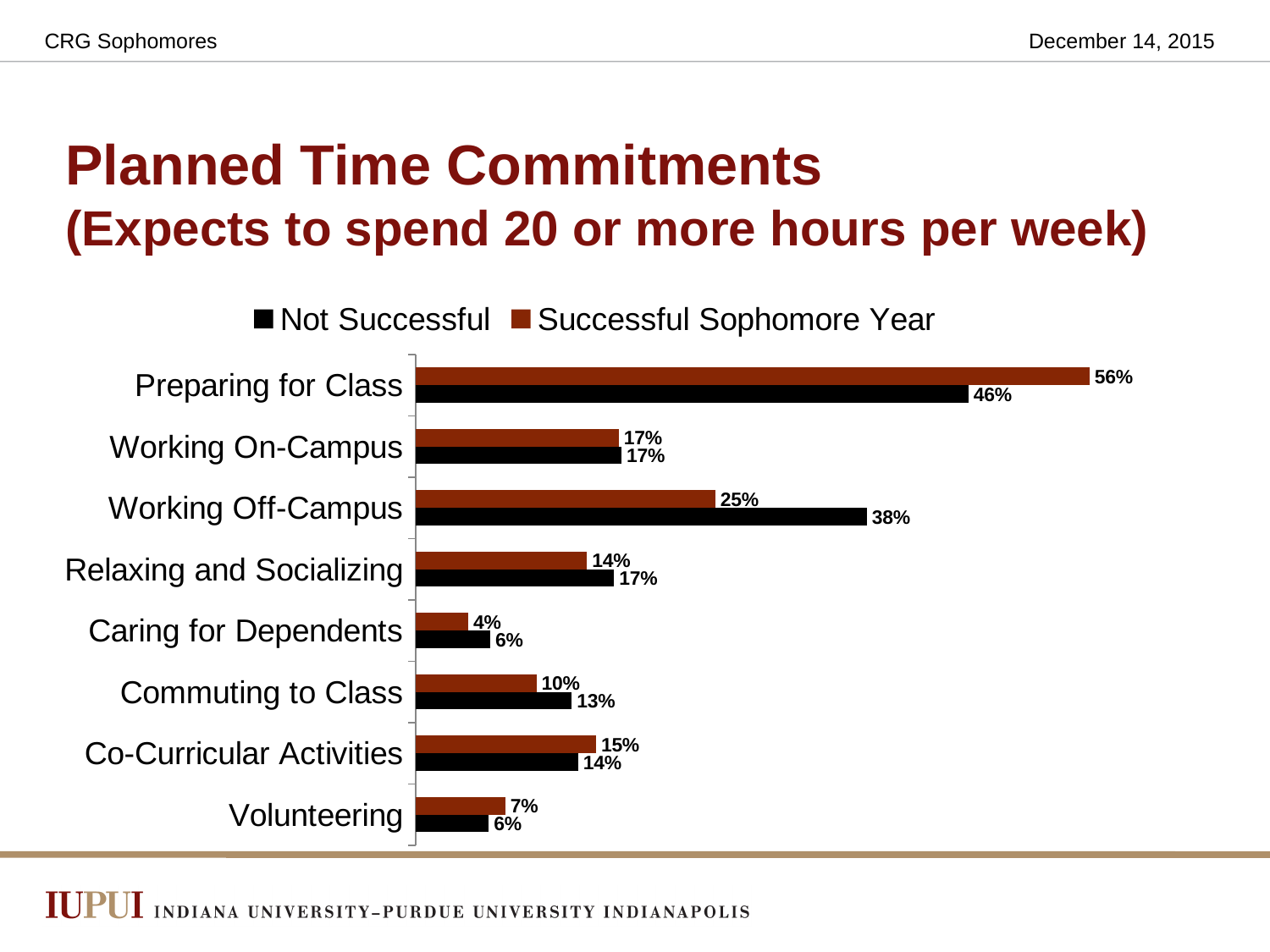
What is the difference between the Successful Sophomore Year and Not Successful values for Preparing for Class? 10% Which category has the highest value for the Not Successful series? Preparing for Class What is the Successful Sophomore Year value for Caring for Dependents? 4% What kind of chart is shown on the slide? Bar chart For Commuting to Class, which series has the larger value, Not Successful or Successful Sophomore Year? Not Successful What percentage of the Successful Sophomore Year group expects to spend 20 or more hours per week Preparing for Class? 56% What is the Not Successful value for Working Off-Campus? 38% Which category has the lowest value for the Successful Sophomore Year series? Caring for Dependents How many series does the legend list? 2 Which colour represents the Successful Sophomore Year series? Dark red What is the difference between the Not Successful and Successful Sophomore Year values for Working Off-Campus? 13% How many categories are shown on the chart? 8